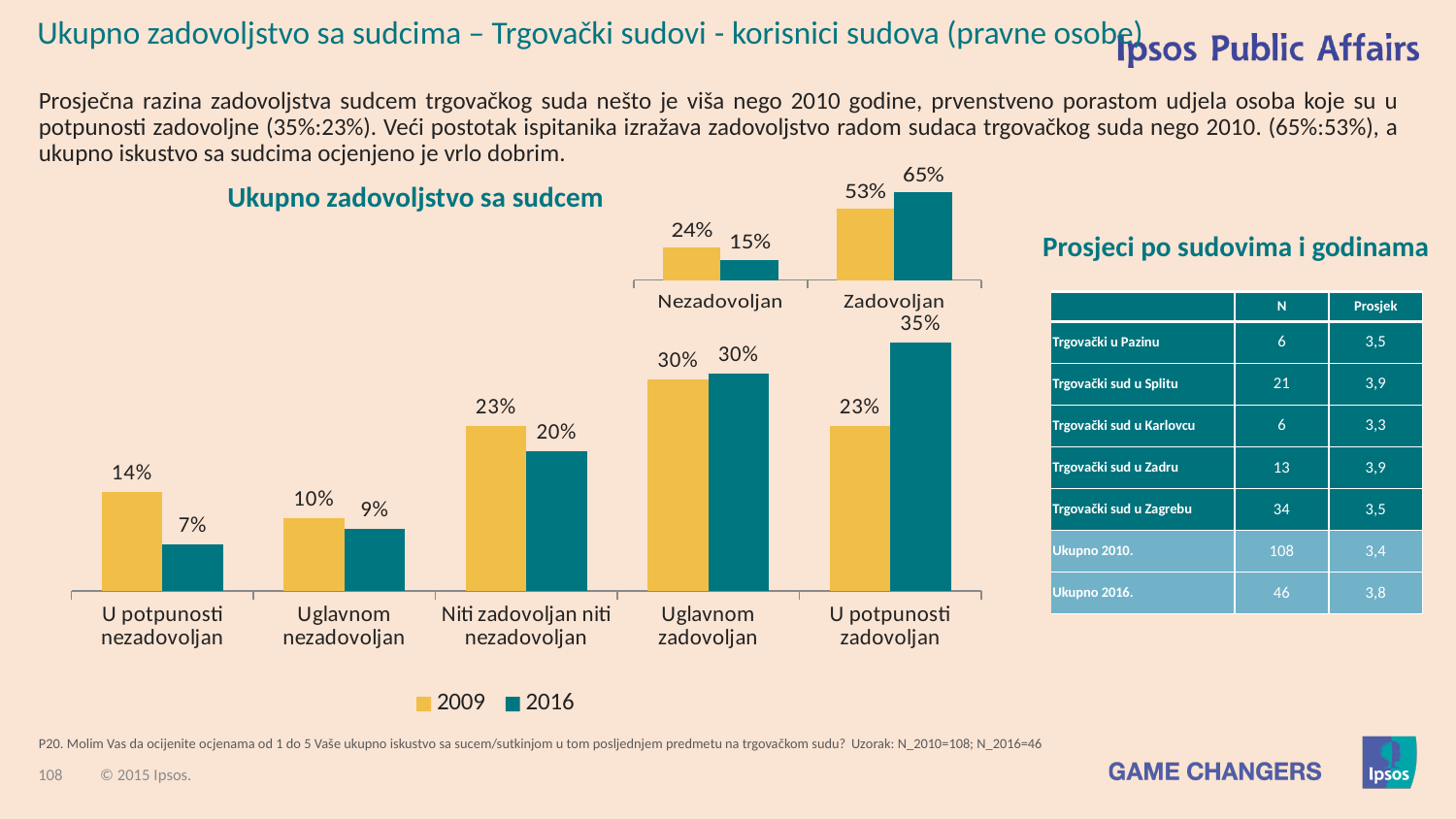
In the small chart above the main chart, what is the 2016 value for 'Zadovoljan'? 65% In the chart 'Ukupno zadovoljstvo sa sudcem', which category has the highest 2016 value? U potpunosti zadovoljan In the chart 'Ukupno zadovoljstvo sa sudcem', what is the 2016 value for 'U potpunosti zadovoljan'? 35% How many categories are shown on the x axis of the chart 'Ukupno zadovoljstvo sa sudcem'? 5 In the chart 'Ukupno zadovoljstvo sa sudcem', what is the difference between the 2016 and 2009 values for 'U potpunosti zadovoljan'? 12% How many series does the legend of the chart 'Ukupno zadovoljstvo sa sudcem' list? 2 In the chart 'Ukupno zadovoljstvo sa sudcem', which is larger for 'Uglavnom nezadovoljan': the 2009 value or the 2016 value? 2009 In the chart 'Ukupno zadovoljstvo sa sudcem', what is the 2009 value for 'U potpunosti nezadovoljan'? 14% In the chart 'Ukupno zadovoljstvo sa sudcem', what is the 2016 value for 'Niti zadovoljan niti nezadovoljan'? 20% What kind of chart is 'Ukupno zadovoljstvo sa sudcem'? Bar chart In the chart 'Ukupno zadovoljstvo sa sudcem', which category has the lowest 2016 value? U potpunosti nezadovoljan